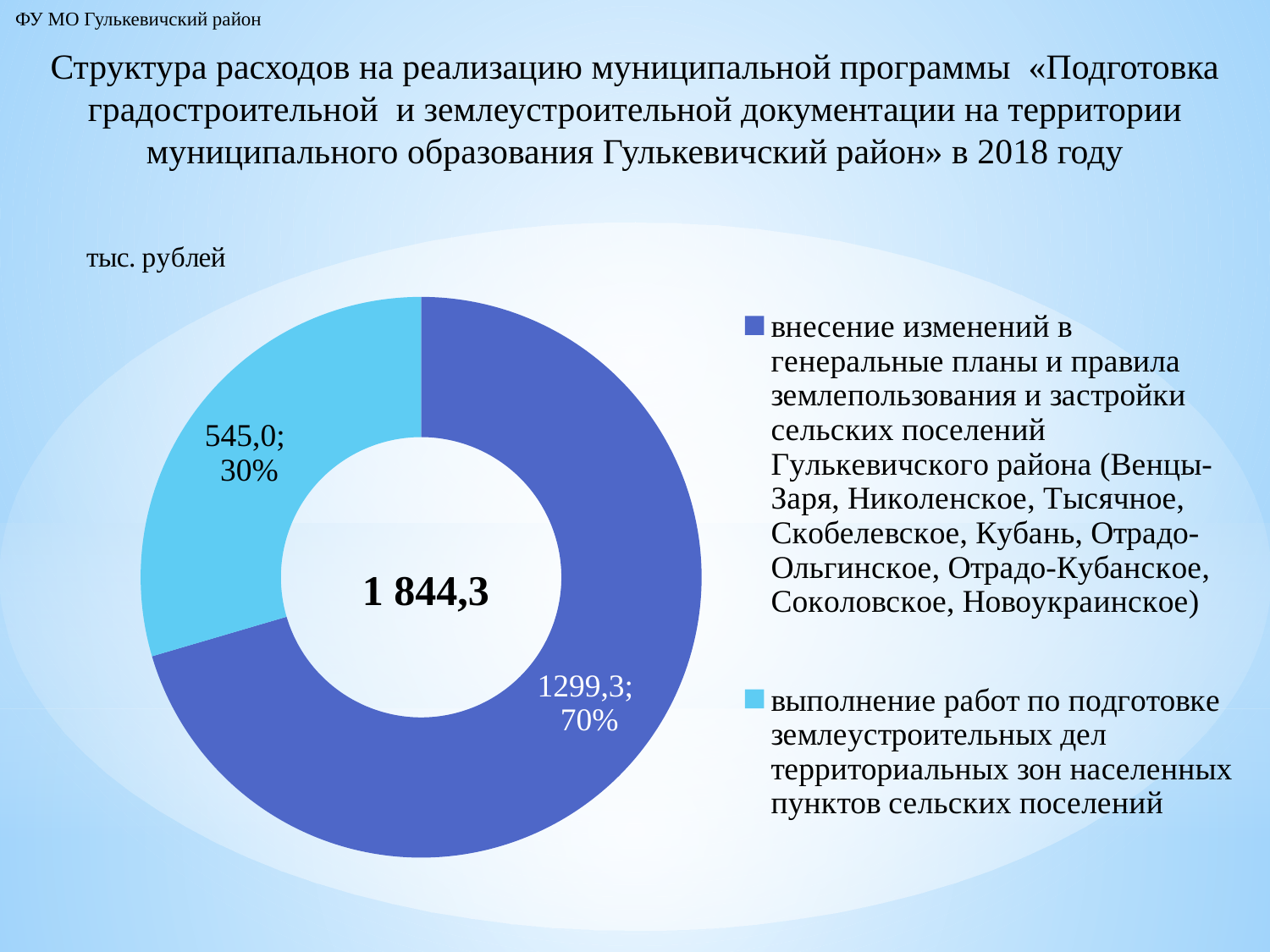
In what units are the values on the chart given? тыс. рублей What is the difference between the value for «внесение изменений в генеральные планы» and the value for «выполнение работ по подготовке землеустроительных дел»? 754,3 What total is shown in the centre of the chart? 1 844,3 What is the value for «внесение изменений в генеральные планы и правила землепользования и застройки сельских поселений Гулькевичского района»? 1299,3 What share of the total does «выполнение работ по подготовке землеустроительных дел» account for? 30% How many slices does the chart have? 2 Which category has the smallest value? выполнение работ по подготовке землеустроительных дел территориальных зон населенных пунктов сельских поселений Which category has the largest value? внесение изменений в генеральные планы и правила землепользования и застройки сельских поселений Гулькевичского района What share of the total does «внесение изменений в генеральные планы и правила землепользования и застройки» account for? 70% What kind of chart is shown on the slide? Pie chart (doughnut) What is the value for «выполнение работ по подготовке землеустроительных дел территориальных зон населенных пунктов сельских поселений»? 545,0 How many entries does the legend list? 2